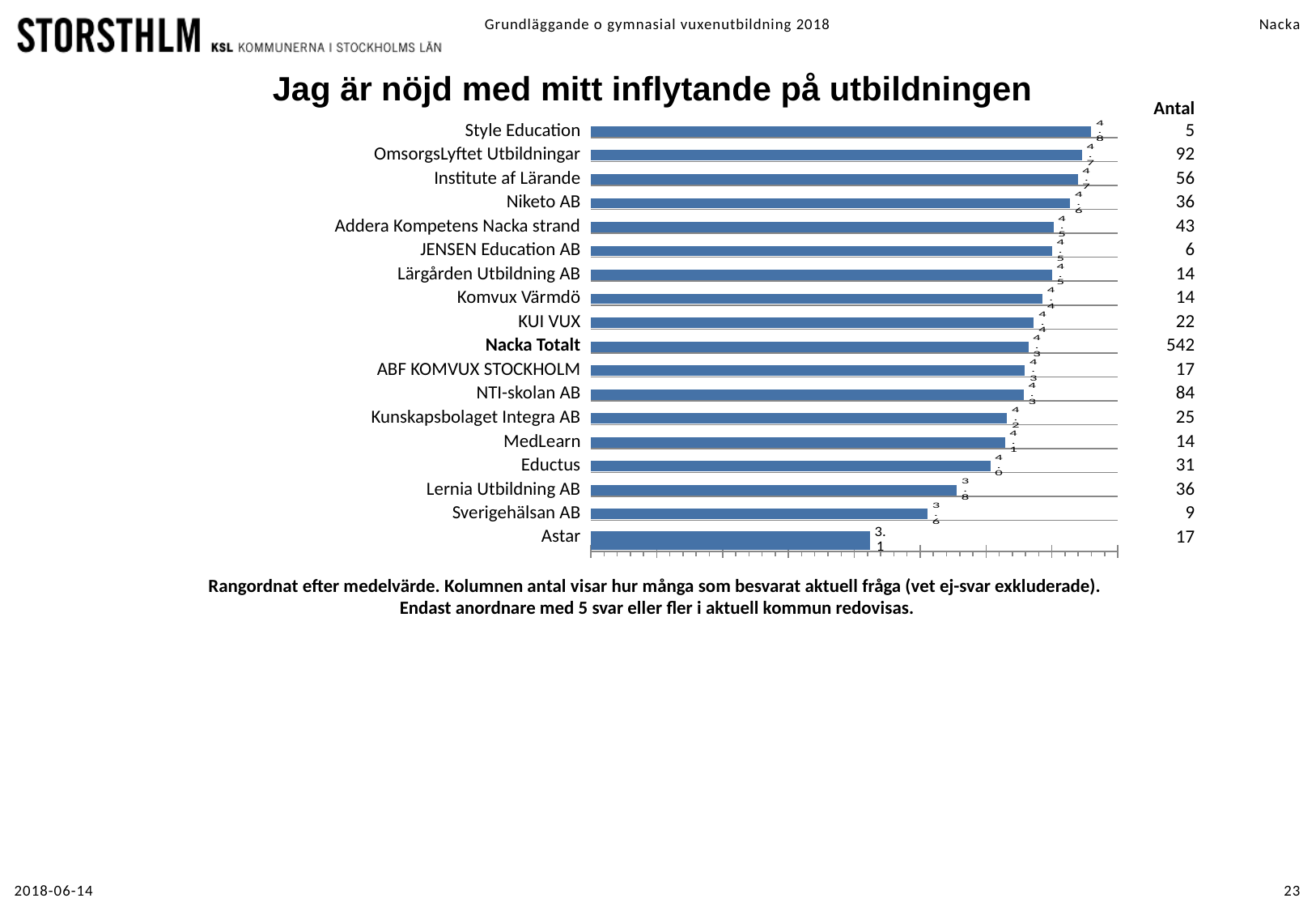
What is the title of the chart? Jag är nöjd med mitt inflytande på utbildningen Which is larger, the value for Niketo AB or the value for Sverigehälsan AB? Niketo AB How many categories are shown in the chart? 18 What kind of chart is shown on the slide? Bar chart What is the value for Style Education? 4.8 What is the difference between the values for Style Education and Astar? 1.7 What is the value for Nacka Totalt? 4.3 What is the value for Lernia Utbildning AB? 3.8 What is the value for Eductus? 4.0 Which category has the highest value? Style Education What is the value for Astar? 3.1 Which category has the lowest value? Astar